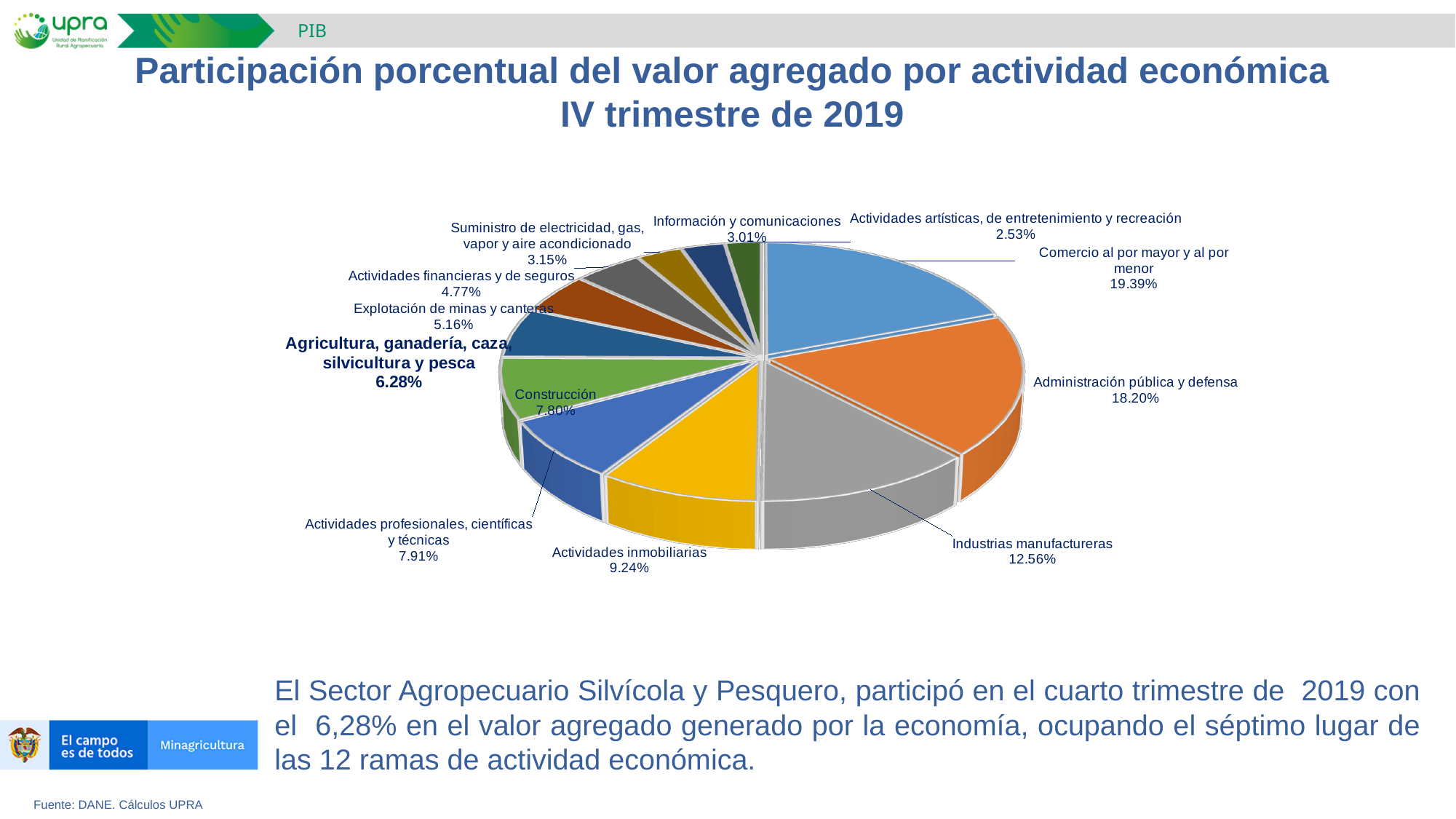
What is the title of the chart on the slide? Participación porcentual del valor agregado por actividad económica IV trimestre de 2019 What is the share of Suministro de electricidad, gas, vapor y aire acondicionado? 3.15% Which economic activity has the largest share in the pie chart? Comercio al por mayor y al por menor What is the share of Administración pública y defensa? 18.20% What is the difference in percentage points between Comercio al por mayor y al por menor and Administración pública y defensa? 1.19 Which economic activity has the smallest share in the pie chart? Actividades artísticas, de entretenimiento y recreación Which has a larger share, Explotación de minas y canteras or Actividades financieras y de seguros? Explotación de minas y canteras Which has a larger share, Construcción or Actividades inmobiliarias? Actividades inmobiliarias How many economic activities (slices) does the pie chart show? 12 What is the share of Industrias manufactureras? 12.56% What is the share of Agricultura, ganadería, caza, silvicultura y pesca? 6.28% What kind of chart is shown on the slide? Pie chart